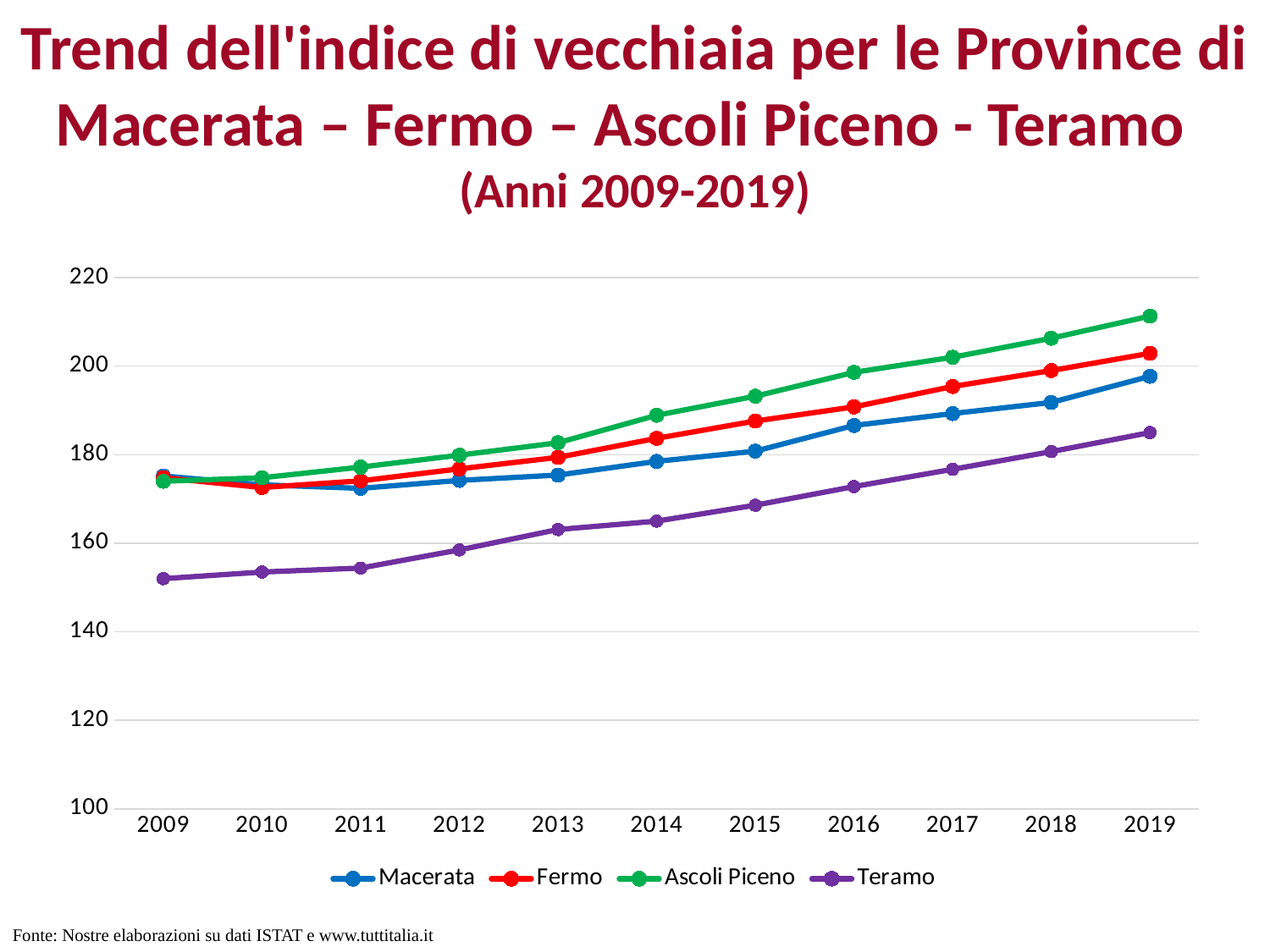
Which province has the highest index value in 2019? Ascoli Piceno Is the value for Macerata in 2013 greater or less than 180? less How many series does the legend list? 4 Is the value for Ascoli Piceno in 2019 greater or less than 200? greater How many years are plotted along the x axis? 11 What colour is the line for Teramo? purple In which year is the value for Teramo lowest? 2009 In 2019, which is larger: the value for Fermo or the value for Macerata? Fermo What kind of chart is shown on the slide? line chart Does the value for Teramo rise or fall from 2009 to 2019? rise Which province has the lowest index value in 2019? Teramo Is the value for Teramo in 2009 greater or less than 160? less